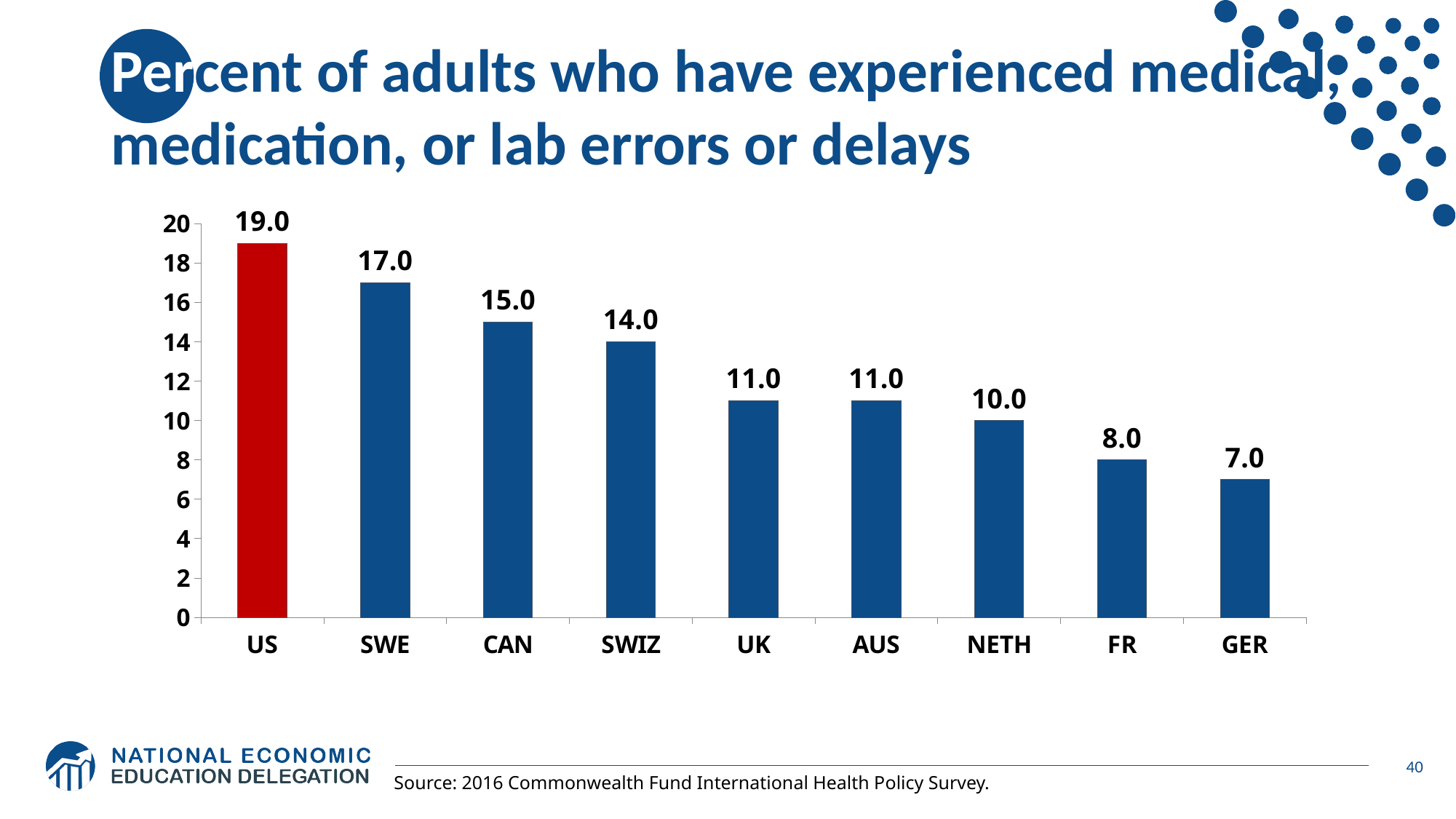
Which country has the lowest value? GER Which is larger, the value for CAN or the value for FR? CAN What is the difference between the values for the US and GER? 12.0 Which country has the highest value? US What is the value for NETH? 10.0 Which bar is coloured red rather than blue? US How many countries are shown on the chart? 9 What kind of chart is shown on the slide? bar chart Do the values rise or fall from left to right across the chart? fall What is the value for the US? 19.0 What is the value for SWIZ? 14.0 What is the difference between the values for SWE and CAN? 2.0